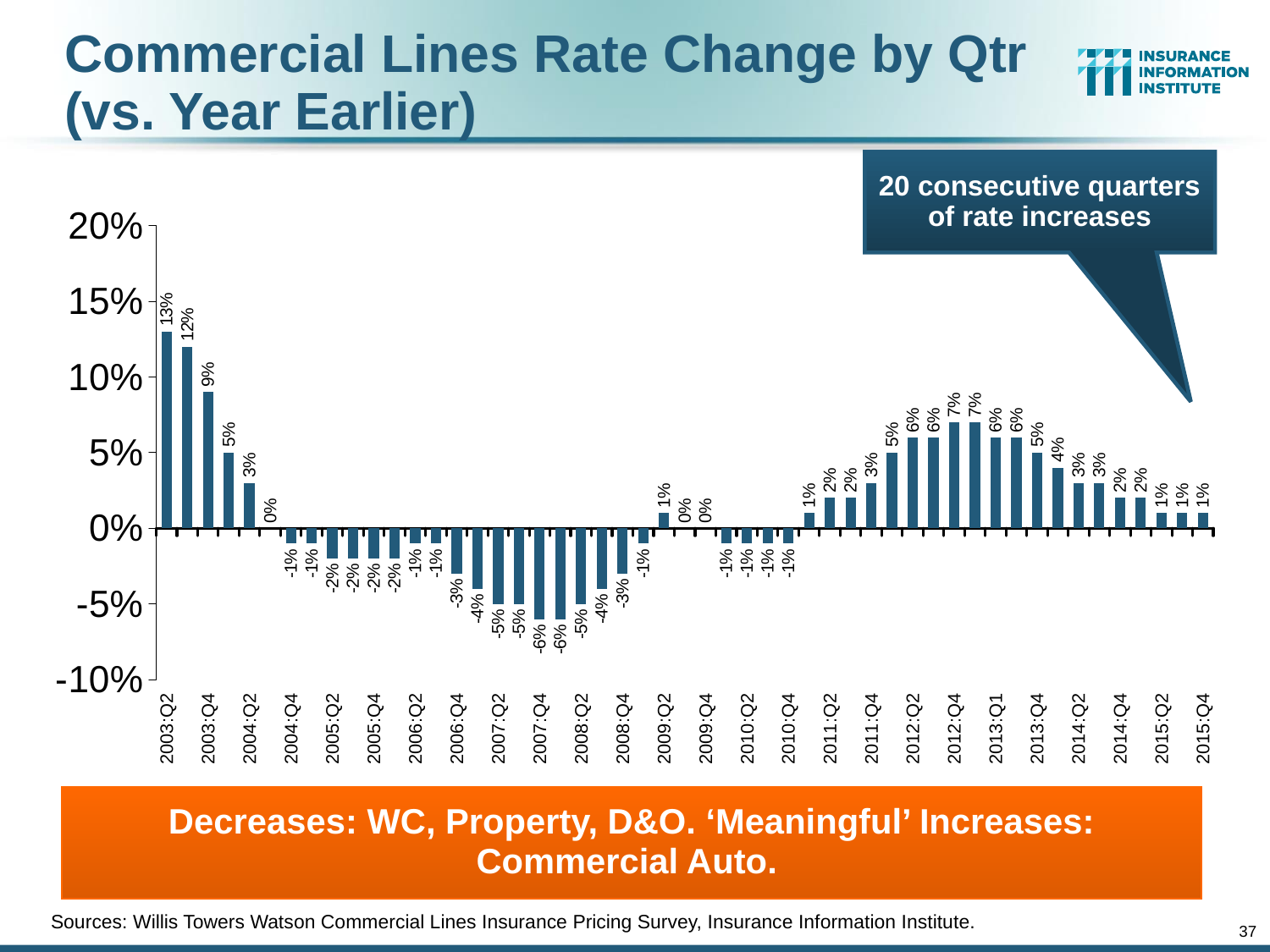
What does the callout box at the top right of the chart say? 20 consecutive quarters of rate increases What is the lowest rate change value shown on the chart? -6% What is the rate change shown for 2015:Q4? 1% Do the values rise or fall from 2003:Q2 to 2004:Q2? Fall Which quarter has the highest rate change on the chart? 2003:Q2 What is the rate change shown for 2007:Q4? -6% What kind of chart is shown on the slide? Bar chart Is the value for 2003:Q2 greater or less than 10%? greater What is the rate change shown for 2009:Q2? 1% By how many percentage points does the 2003:Q2 value exceed the 2003:Q4 value? 4 percentage points Which is larger, the rate change for 2003:Q4 or for 2012:Q4? 2003:Q4 What is the commercial lines rate change shown for 2003:Q2? 13%